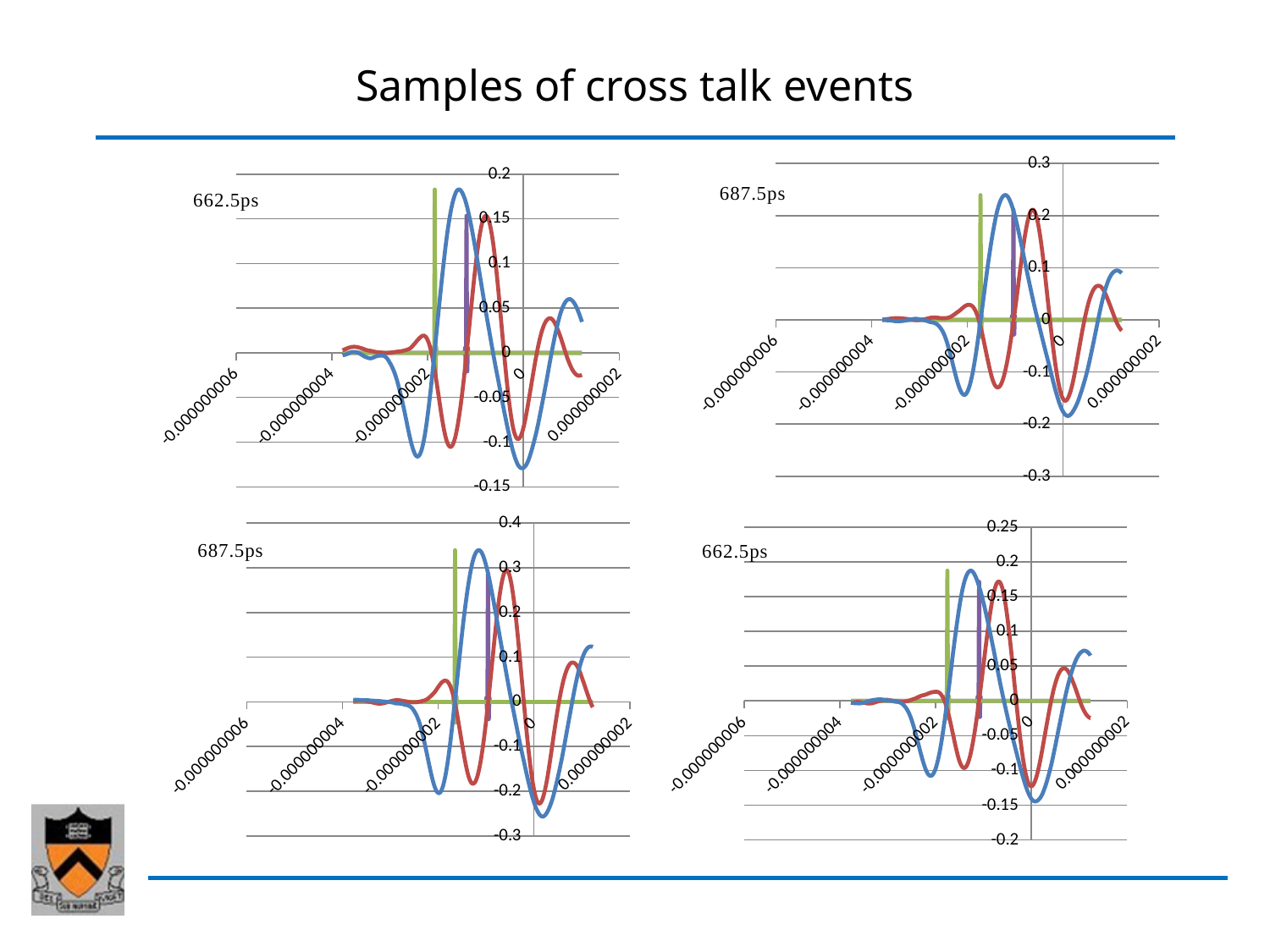
What time label is printed on the bottom-left chart? 687.5ps In the top-left chart, is the lowest value of the blue line greater or less than -0.1? less In the top-right chart, which line reaches a higher peak, the blue line or the red line? blue line In the bottom-left chart, is the lowest value of the blue line greater or less than -0.2? less How many charts are shown on the slide? 4 In the top-left chart, is the peak value of the blue line greater or less than 0.15? greater What kind of chart is the top-left chart? line chart What time label is printed on the top-left chart? 662.5ps